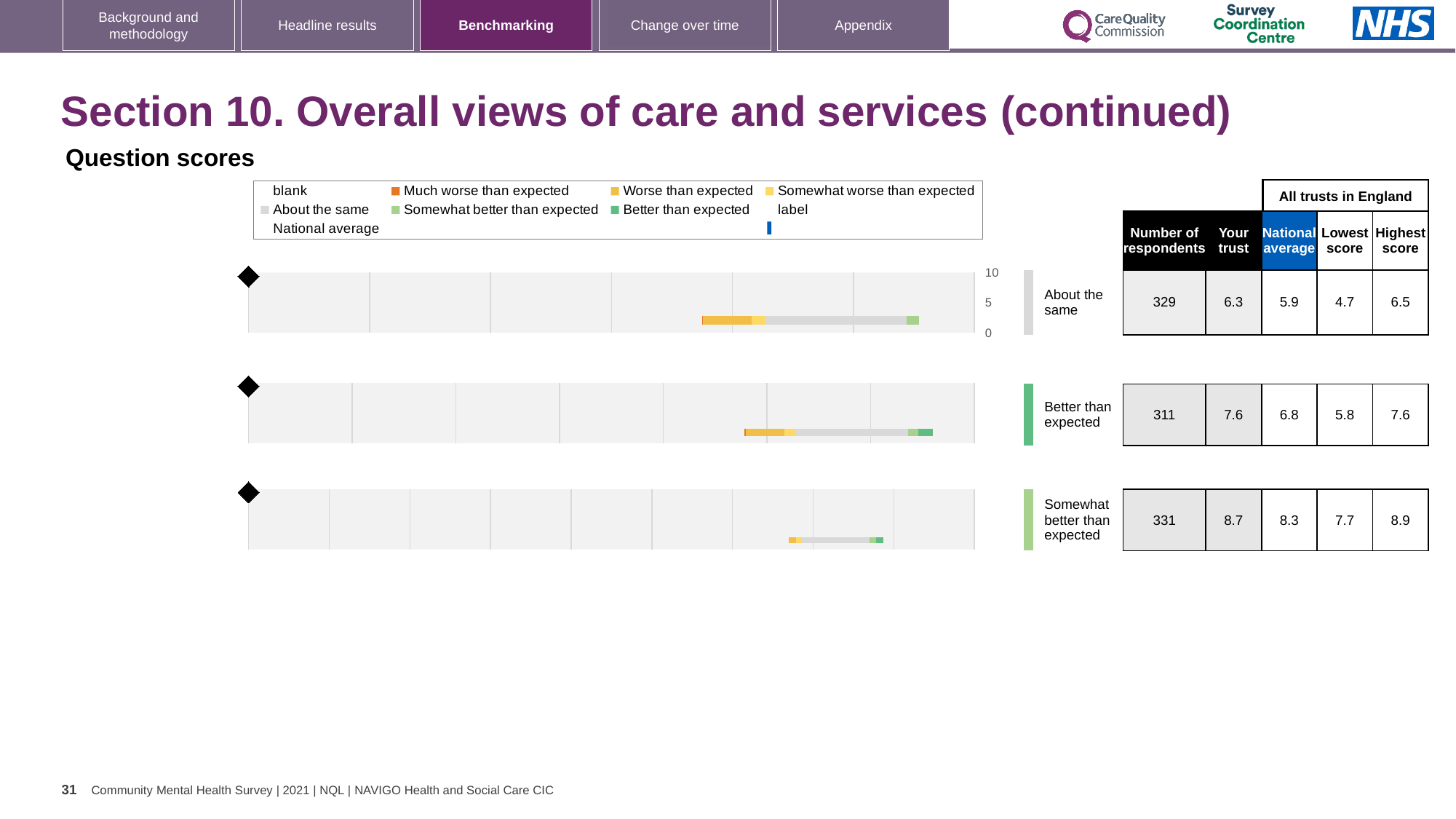
How many respondents are listed for the row labelled 'Somewhat better than expected'? 331 What is the national average for the row labelled 'Better than expected'? 6.8 What is the difference between the 'Your trust' score and the national average for the row labelled 'Better than expected'? 0.8 What is the lowest score across all trusts in England for the row labelled 'About the same'? 4.7 Which of the three rows has the lowest national average? About the same What is the 'Your trust' score for the row labelled 'About the same'? 6.3 Which of the three rows has the highest 'Your trust' score? Somewhat better than expected Which legend entry is shown with a dark green colour? Better than expected What is the highest score across all trusts in England for the row labelled 'Somewhat better than expected'? 8.9 How many benchmarking charts are shown on the slide? 3 What kind of chart is used for the benchmarking rows on the slide? Bar chart Is the 'Your trust' score for 'About the same' larger or smaller than its national average? larger